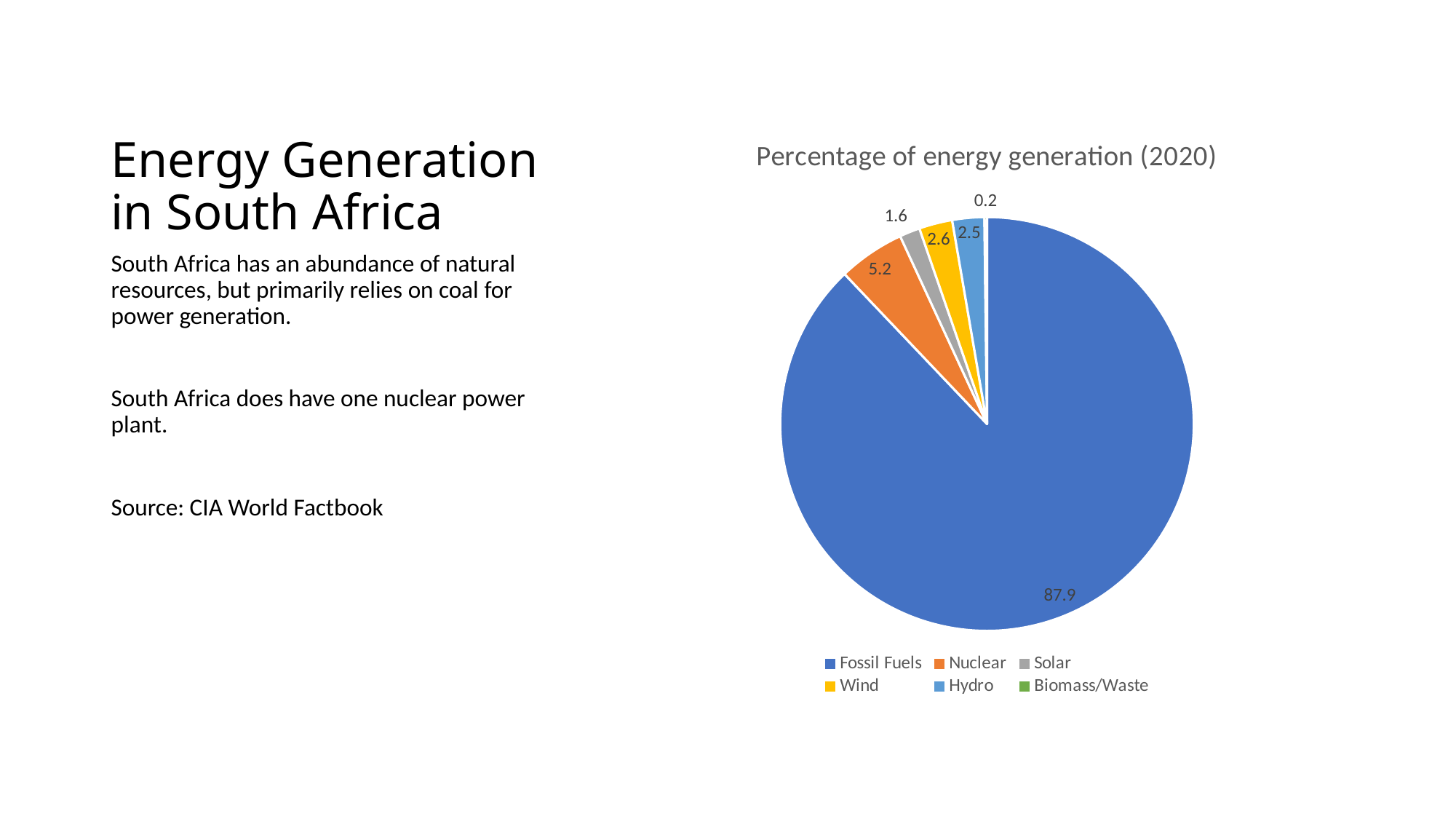
How many categories does the pie chart's legend list? 6 What is the value for Hydro in the pie chart? 2.5 What is the value for Nuclear in the pie chart? 5.2 What is the difference between the values for Nuclear and Wind? 2.6 What is the difference between the values for Fossil Fuels and Nuclear? 82.7 Which category has the largest slice of the pie chart? Fossil Fuels Which category has the smallest slice of the pie chart? Biomass/Waste Which is larger, the value for Nuclear or the value for Solar? Nuclear What is the value for Fossil Fuels in the pie chart? 87.9 What is the title of the chart? Percentage of energy generation (2020) What is the value for Biomass/Waste in the pie chart? 0.2 What is the value for Solar in the pie chart? 1.6